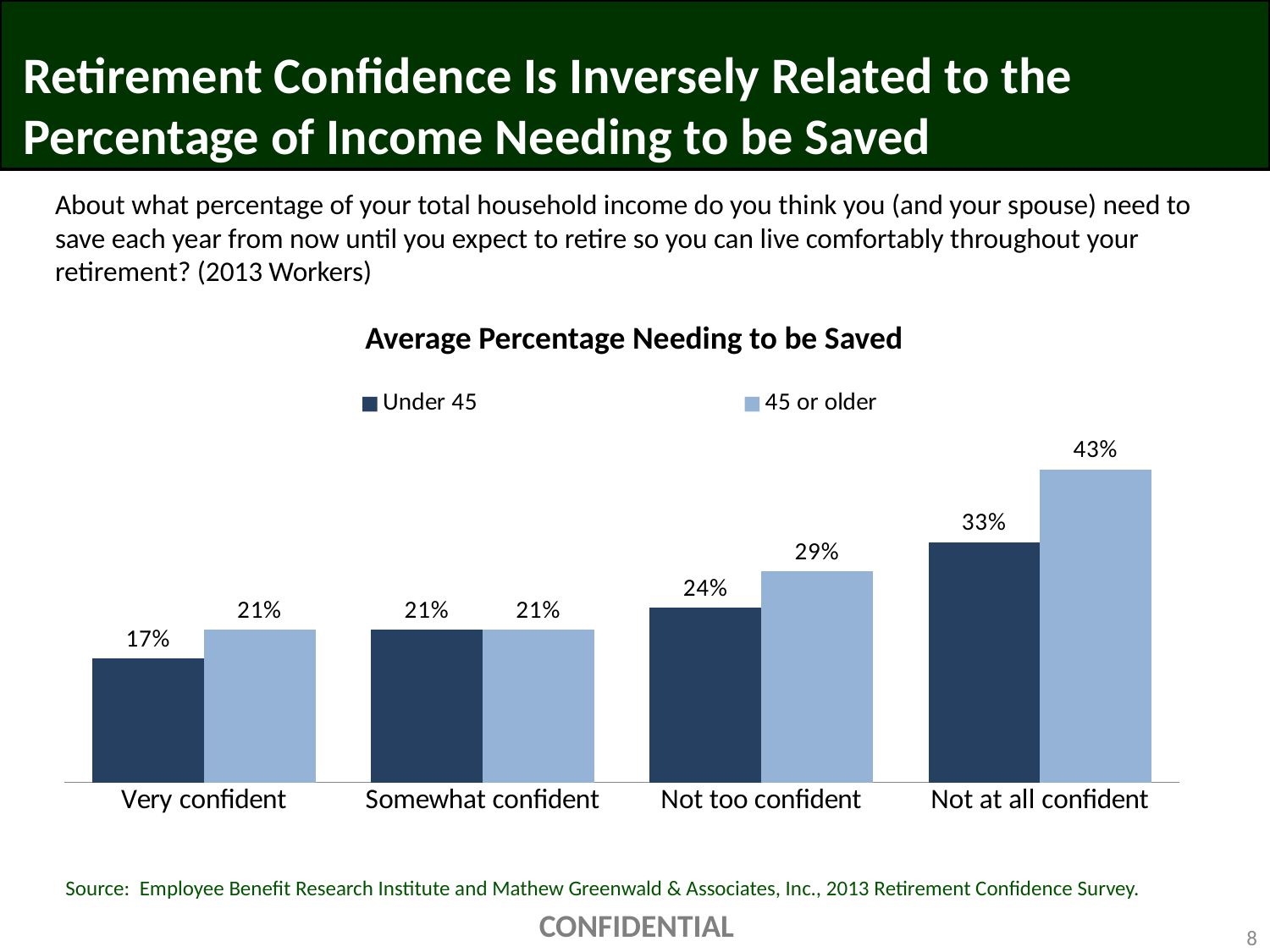
What is the value for 45 or older in the Not at all confident category? 43% Which is larger in the Not too confident category: Under 45 or 45 or older? 45 or older What kind of chart is shown? Bar chart What is the difference between the 45 or older and Under 45 values in the Not at all confident category? 10% Do the Under 45 values rise or fall from Very confident to Not at all confident? Rise What is the value for 45 or older in the Not too confident category? 29% How many series does the legend list? 2 How many categories are shown on the x axis? 4 What is the value for Under 45 in the Very confident category? 17% What is the title of the chart? Average Percentage Needing to be Saved Which category has the highest value for Under 45? Not at all confident Which category has the lowest value for Under 45? Very confident